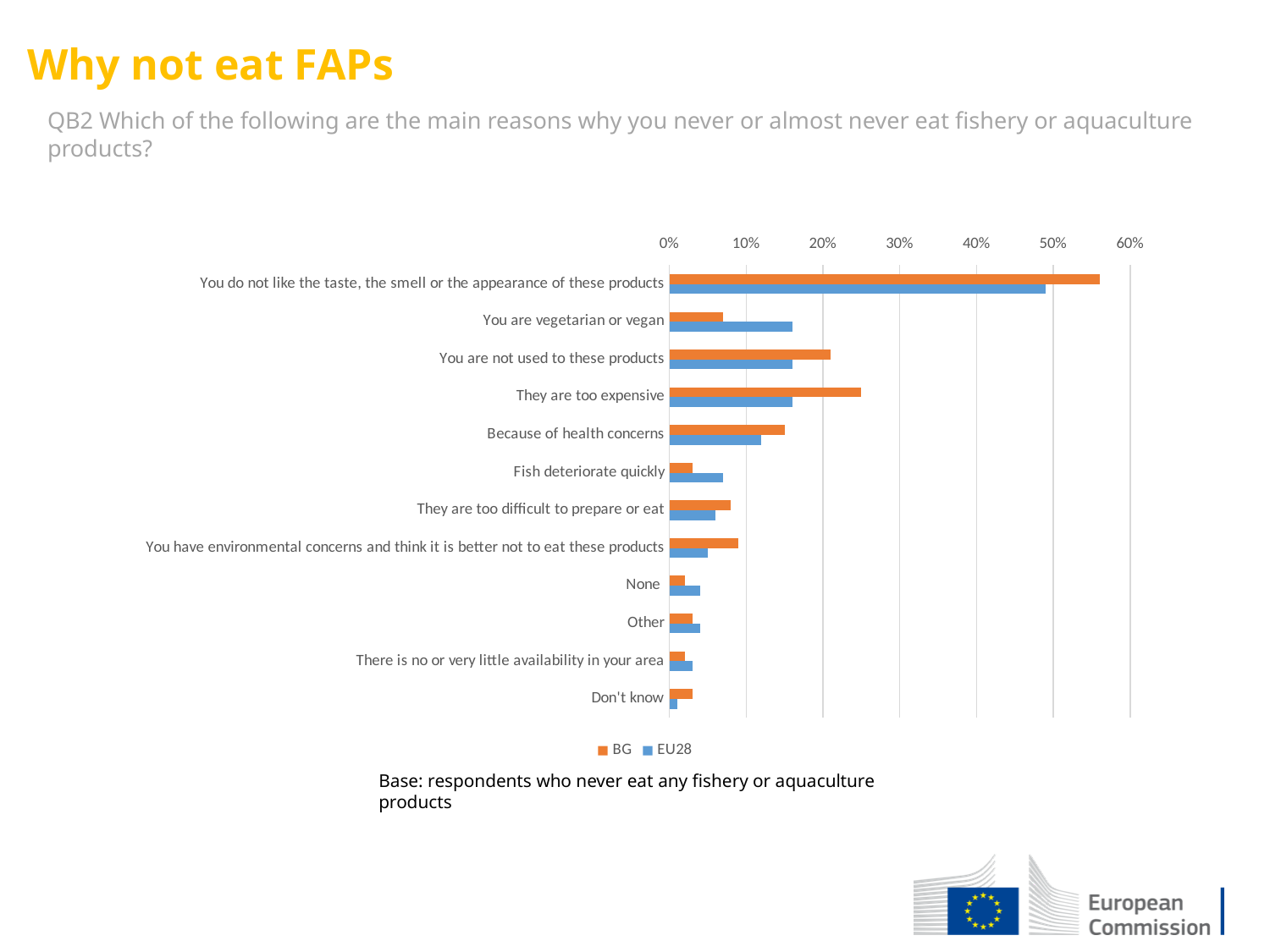
How many reason categories are plotted on the chart? 12 Which is larger for 'You are vegetarian or vegan', the BG value or the EU28 value? EU28 Which is larger for 'Fish deteriorate quickly', the BG value or the EU28 value? EU28 Is the EU28 value for 'You are vegetarian or vegan' greater or less than 10%? greater Is the BG value for 'You do not like the taste, the smell or the appearance of these products' greater or less than 50%? greater What kind of chart is shown on the slide? bar chart How many series does the legend list? 2 Which category has the highest BG value? You do not like the taste, the smell or the appearance of these products Which is larger for 'They are too expensive', the BG value or the EU28 value? BG Which colour represents the BG series in the chart? orange Is the BG value for 'They are too expensive' greater or less than 20%? greater